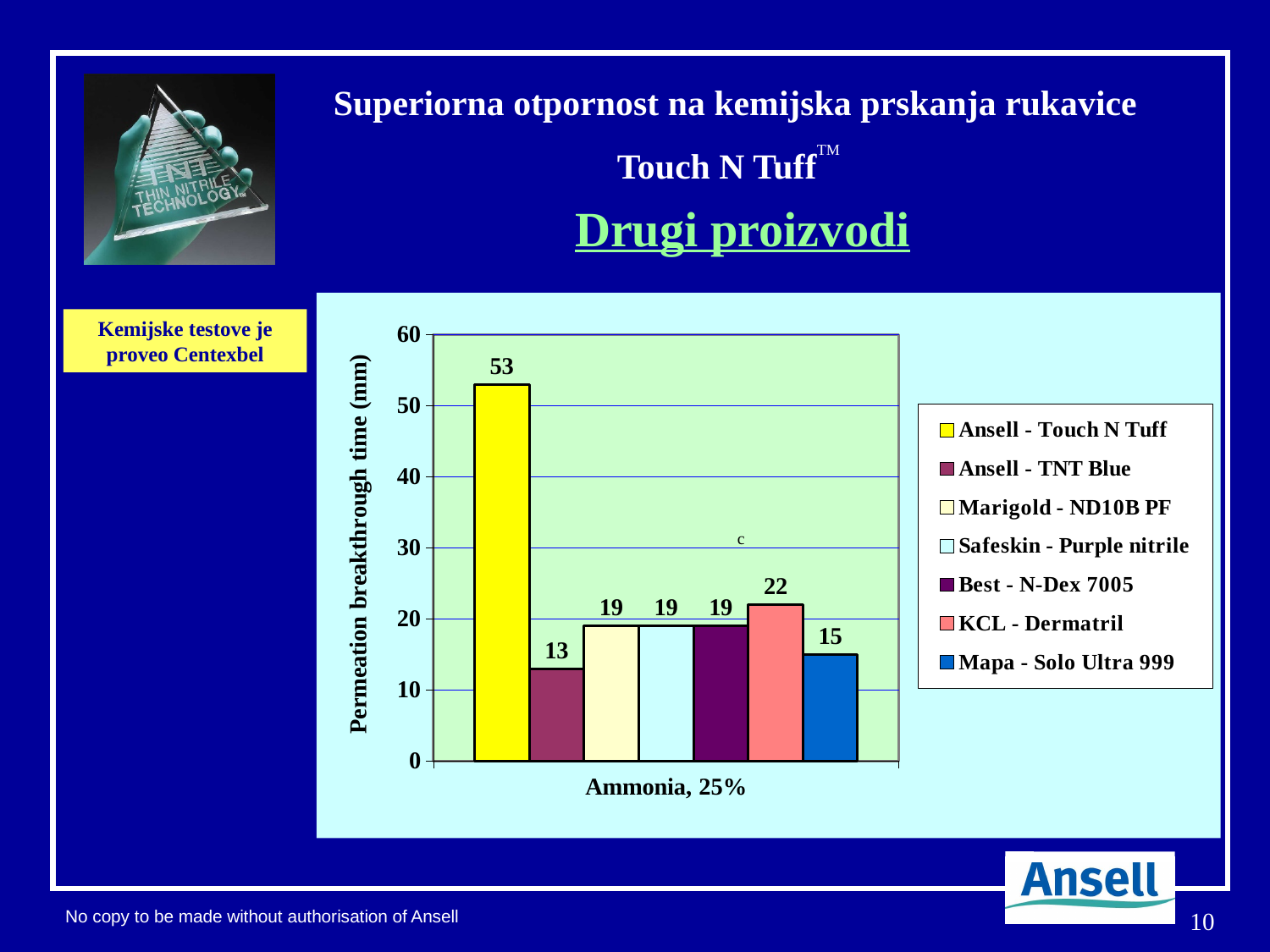
Which product has the lowest permeation breakthrough time? Ansell - TNT Blue What is the permeation breakthrough time for Ansell - TNT Blue? 13 Which has a larger permeation breakthrough time, KCL - Dermatril or Mapa - Solo Ultra 999? KCL - Dermatril Which product has the highest permeation breakthrough time? Ansell - Touch N Tuff How many series does the legend list? 7 What is the permeation breakthrough time for Mapa - Solo Ultra 999? 15 Is the value for Ansell - Touch N Tuff greater or less than 50? greater What kind of chart is shown on the slide? bar chart What is the difference in permeation breakthrough time between Ansell - Touch N Tuff and KCL - Dermatril? 31 What is the label on the x axis of the chart? Ammonia, 25% What is the permeation breakthrough time for KCL - Dermatril? 22 What is the permeation breakthrough time for Ansell - Touch N Tuff? 53